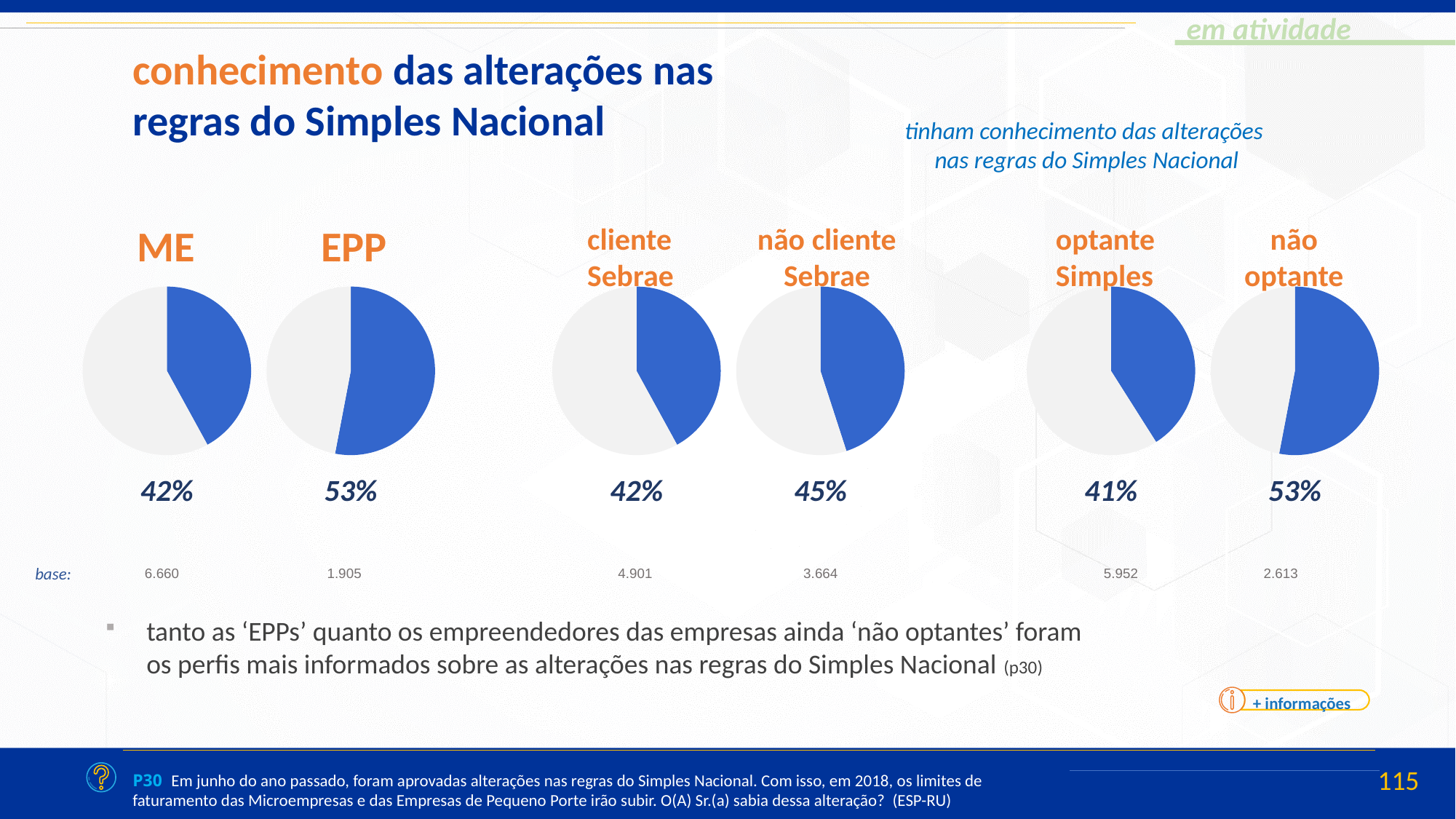
In the EPP pie chart, what percentage is shown for the blue slice? 53% In the ME pie chart, what percentage is shown for the blue slice? 42% What kind of chart is used to show the ME value? Pie chart In the 'não cliente Sebrae' pie chart, what percentage is shown? 45% What is the difference between the EPP percentage and the ME percentage? 11% In the 'optante Simples' pie chart, what percentage is shown? 41% How many pie charts are shown on the slide? 6 Which of the six pie charts shows the lowest percentage? optante Simples What is the base (sample size) shown under the 'não optante' pie chart? 2.613 Which is larger, the 'cliente Sebrae' percentage or the 'não cliente Sebrae' percentage? não cliente Sebrae What is the base (sample size) shown under the ME pie chart? 6.660 What is the difference between the 'não optante' percentage and the 'optante Simples' percentage? 12%